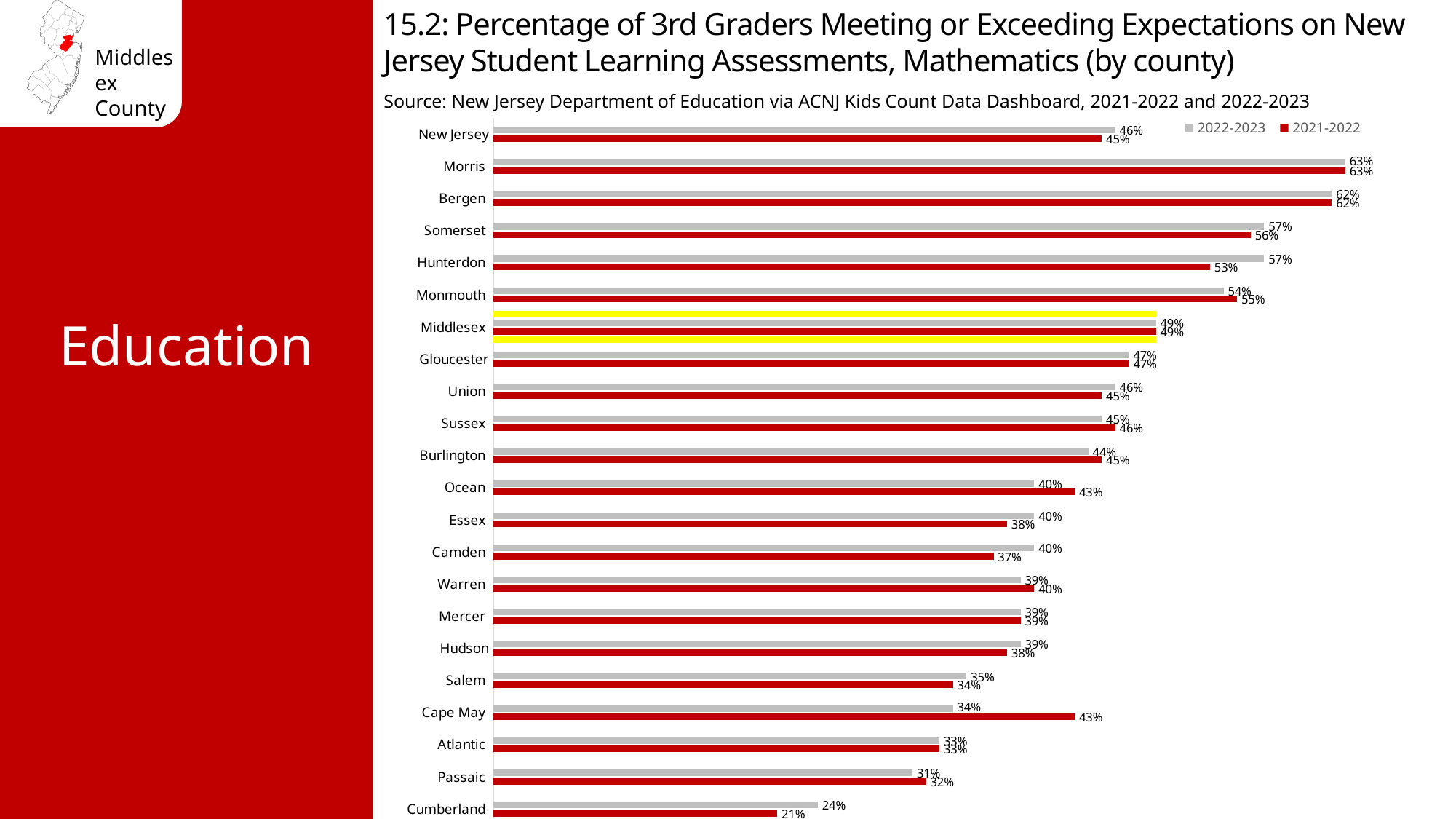
What is the value for Middlesex in 2022-2023? 49% What kind of chart is shown on the slide? Bar chart What is the value for Cumberland in 2021-2022? 21% Which county has the lowest value for 2022-2023? Cumberland What is the difference between Hunterdon's 2022-2023 value and its 2021-2022 value? 4 percentage points For Cape May, which is larger: the 2022-2023 value or the 2021-2022 value? 2021-2022 Which county is highlighted in yellow on the chart? Middlesex How many series does the legend list? 2 What is the value for Cape May in 2021-2022? 43% Which county has the highest value for 2022-2023? Morris How many categories (counties plus New Jersey) are shown on the chart? 22 What is the difference between Cape May's 2021-2022 value and its 2022-2023 value? 9 percentage points